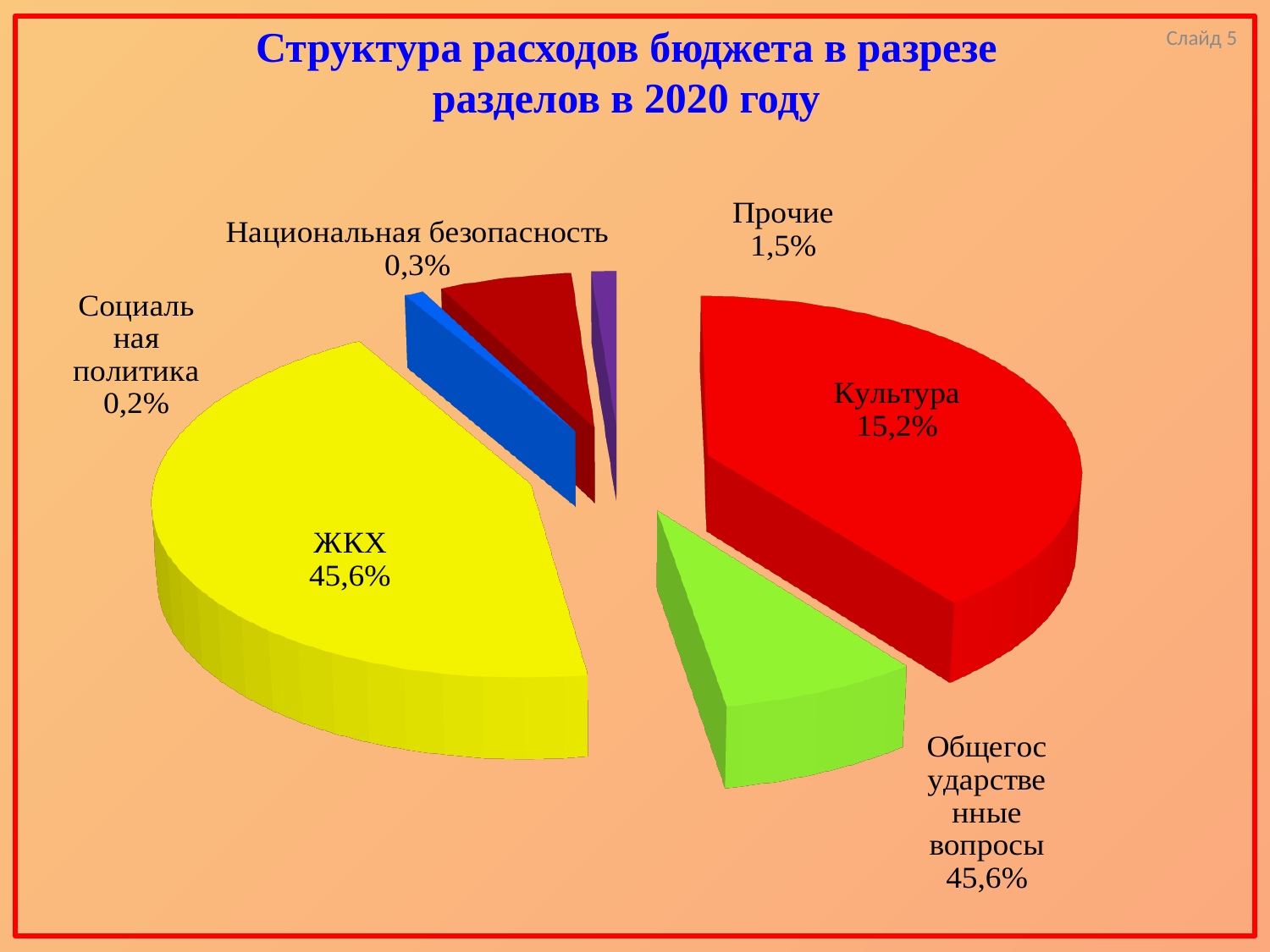
What is the share of Национальная безопасность in the pie chart? 0,3% Which is larger, the share of ЖКХ or the share of Культура? ЖКХ What is the share of Социальная политика in the pie chart? 0,2% What type of chart is shown on the slide? pie chart What colour is the ЖКХ slice in the pie chart? yellow What is the share of Прочие in the pie chart? 1,5% What is the difference between the shares of ЖКХ and Культура? 30,4% What is the share of Культура in the pie chart? 15,2% What is the share of ЖКХ in the pie chart? 45,6% Which category has the smallest share in the pie chart? Социальная политика How many slices does the pie chart have? 6 What is the difference between the shares of Культура and Прочие? 13,7%